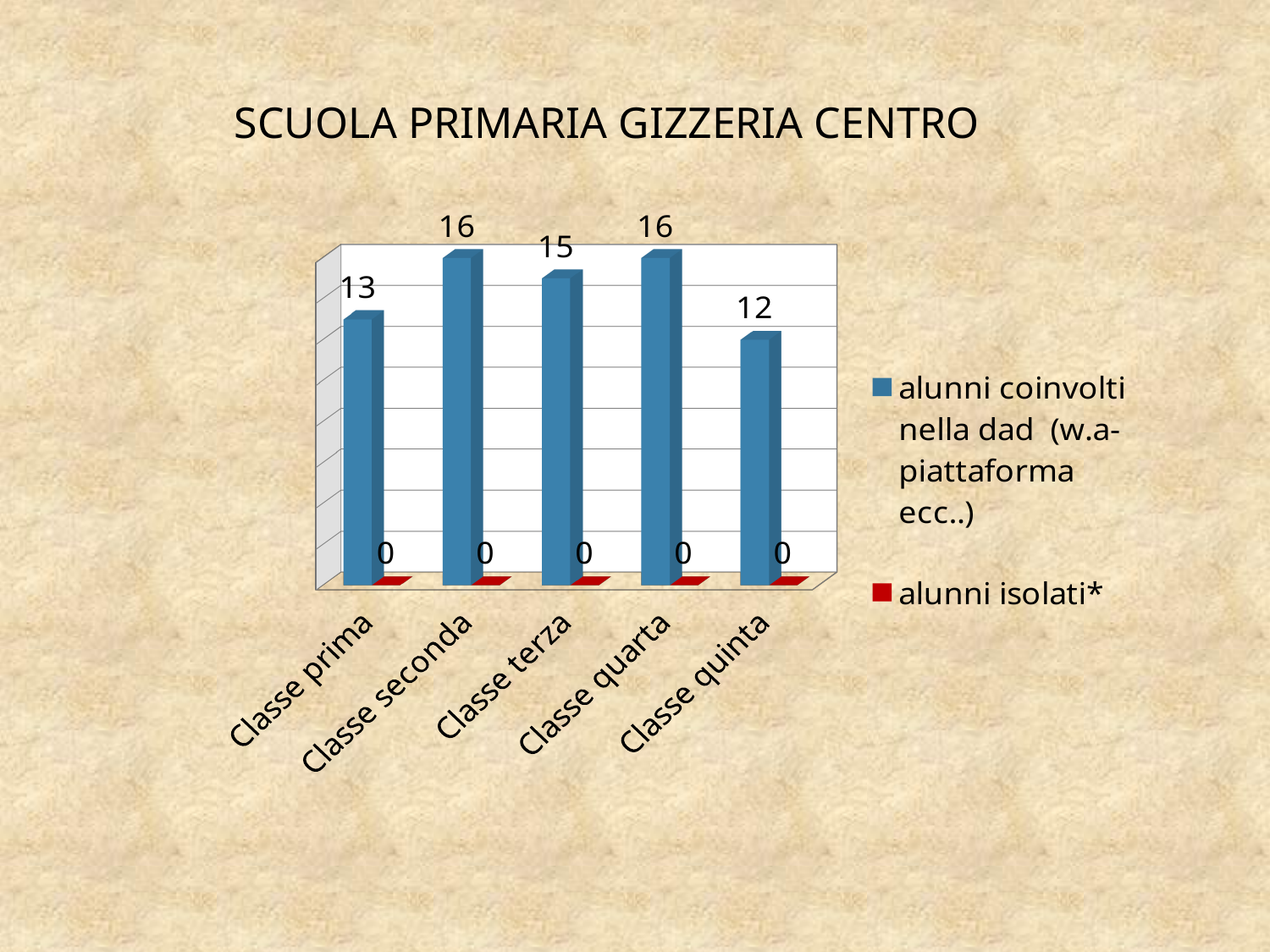
What kind of chart is shown on the slide? Bar chart What is the value for Classe quinta in the 'alunni coinvolti nella dad' series? 12 What is the value for Classe seconda in the 'alunni isolati*' series? 0 What colour are the bars for the 'alunni isolati*' series? Red Which is larger for 'alunni coinvolti nella dad': Classe prima or Classe terza? Classe terza What is the value for Classe prima in the 'alunni coinvolti nella dad' series? 13 What is the title of the slide? SCUOLA PRIMARIA GIZZERIA CENTRO How many classes are shown on the x axis? 5 What is the difference between the 'alunni coinvolti nella dad' values for Classe seconda and Classe quinta? 4 What is the value for Classe terza in the 'alunni coinvolti nella dad' series? 15 Which class has the lowest value for 'alunni coinvolti nella dad'? Classe quinta How many series does the legend list? 2